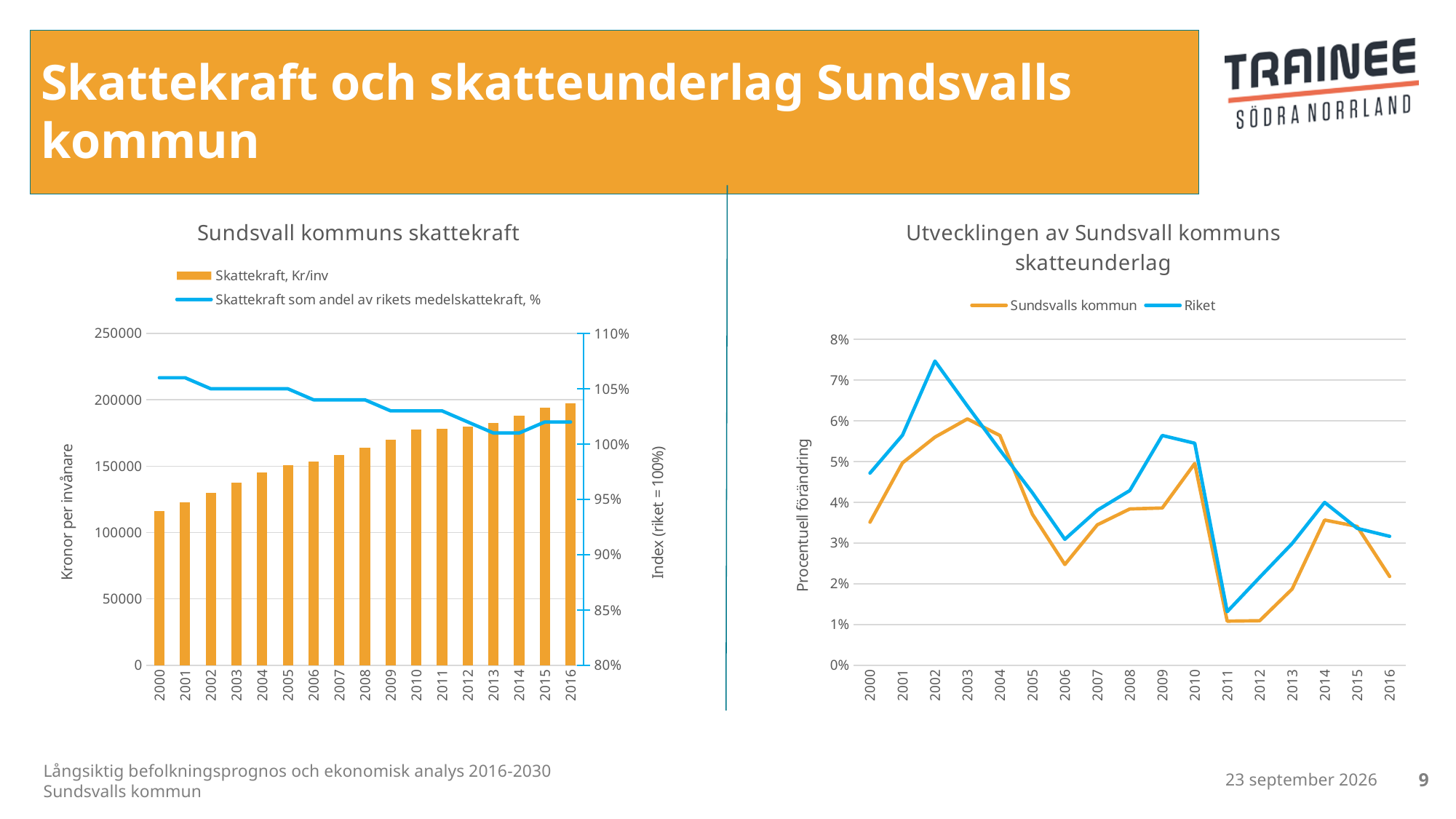
On the left chart 'Sundsvall kommuns skattekraft', which year has the lowest bar for Skattekraft, Kr/inv? 2000 On the right chart 'Utvecklingen av Sundsvall kommuns skatteunderlag', in which year does the Riket line reach its highest value? 2002 On the left chart 'Sundsvall kommuns skattekraft', which year has the highest bar for Skattekraft, Kr/inv? 2016 On the left chart 'Sundsvall kommuns skattekraft', does the line 'Skattekraft som andel av rikets medelskattekraft, %' rise or fall from 2000 to 2016? fall On the right chart 'Utvecklingen av Sundsvall kommuns skatteunderlag', is the Riket value for 2002 greater or less than 7%? greater On the left chart 'Sundsvall kommuns skattekraft', do the Skattekraft, Kr/inv bars rise or fall from 2000 to 2016? rise On the right chart 'Utvecklingen av Sundsvall kommuns skatteunderlag', what kind of chart is it? line chart On the left chart 'Sundsvall kommuns skattekraft', is the Skattekraft, Kr/inv bar for 2000 greater or less than 150000? less On the right chart 'Utvecklingen av Sundsvall kommuns skatteunderlag', which series has the higher value in 2016, Sundsvalls kommun or Riket? Riket On the left chart 'Sundsvall kommuns skattekraft', how many series does the legend list? 2 On the left chart 'Sundsvall kommuns skattekraft', how many years are shown on the x axis? 17 On the left chart 'Sundsvall kommuns skattekraft', is the Skattekraft, Kr/inv bar for 2016 greater or less than 150000? greater